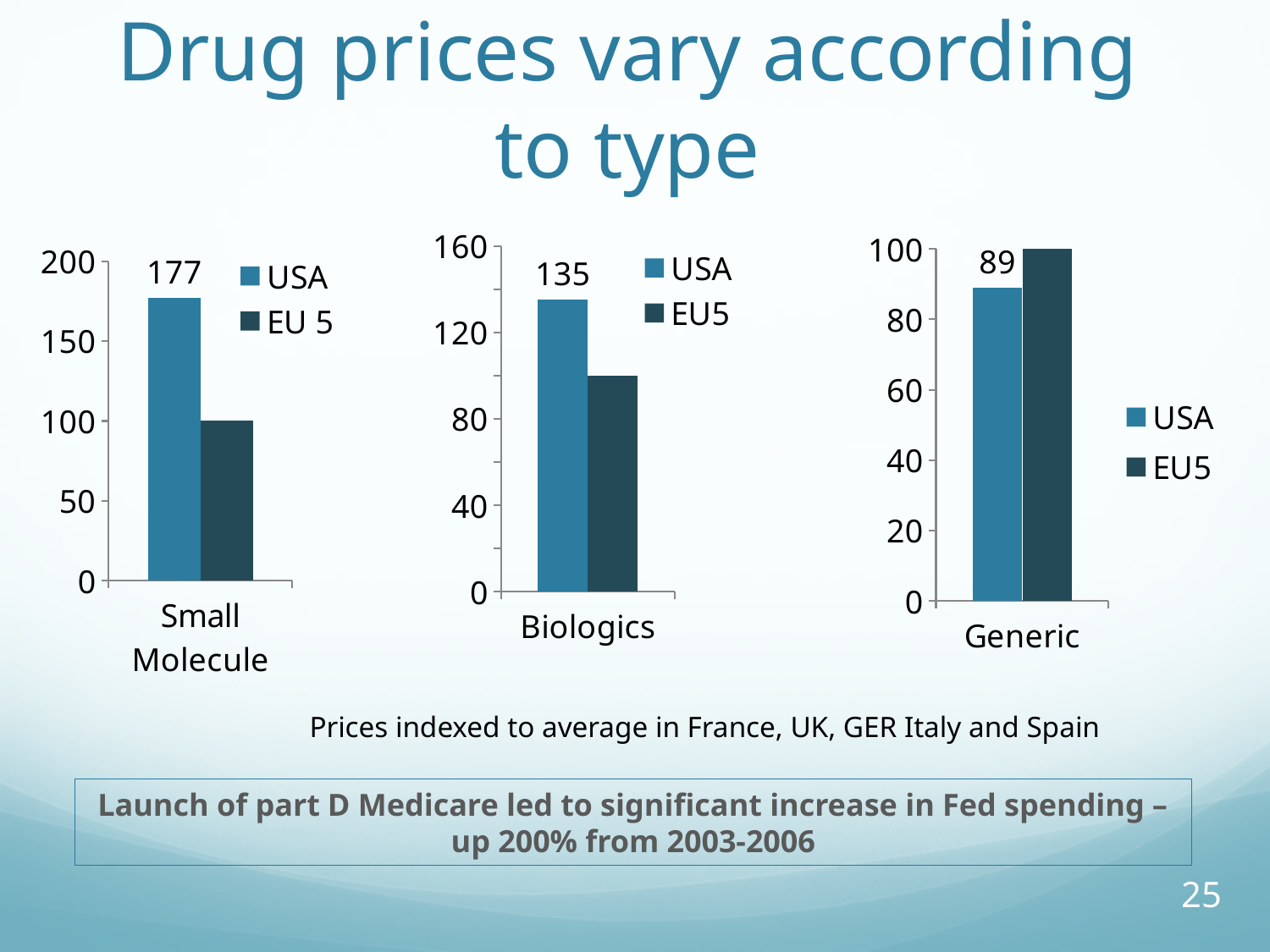
In the Generic chart, which series has the higher value, USA or EU5? EU5 In the Biologics chart, is the value for EU5 greater or less than 80? greater How many series does the legend of the Small Molecule chart list? 2 What kind of chart is the Generic chart? bar chart In the Biologics chart, which series has the higher value, USA or EU5? USA In the Biologics chart, what is the value for USA? 135 In the Generic chart, what is the value for USA? 89 In the Small Molecule chart, what is the value for EU 5? 100 In the Small Molecule chart, what is the difference between the USA and EU 5 values? 77 In the Biologics chart, is the value for EU5 greater or less than 120? less How many charts are shown on the slide? 3 In the Small Molecule chart, what is the value for USA? 177